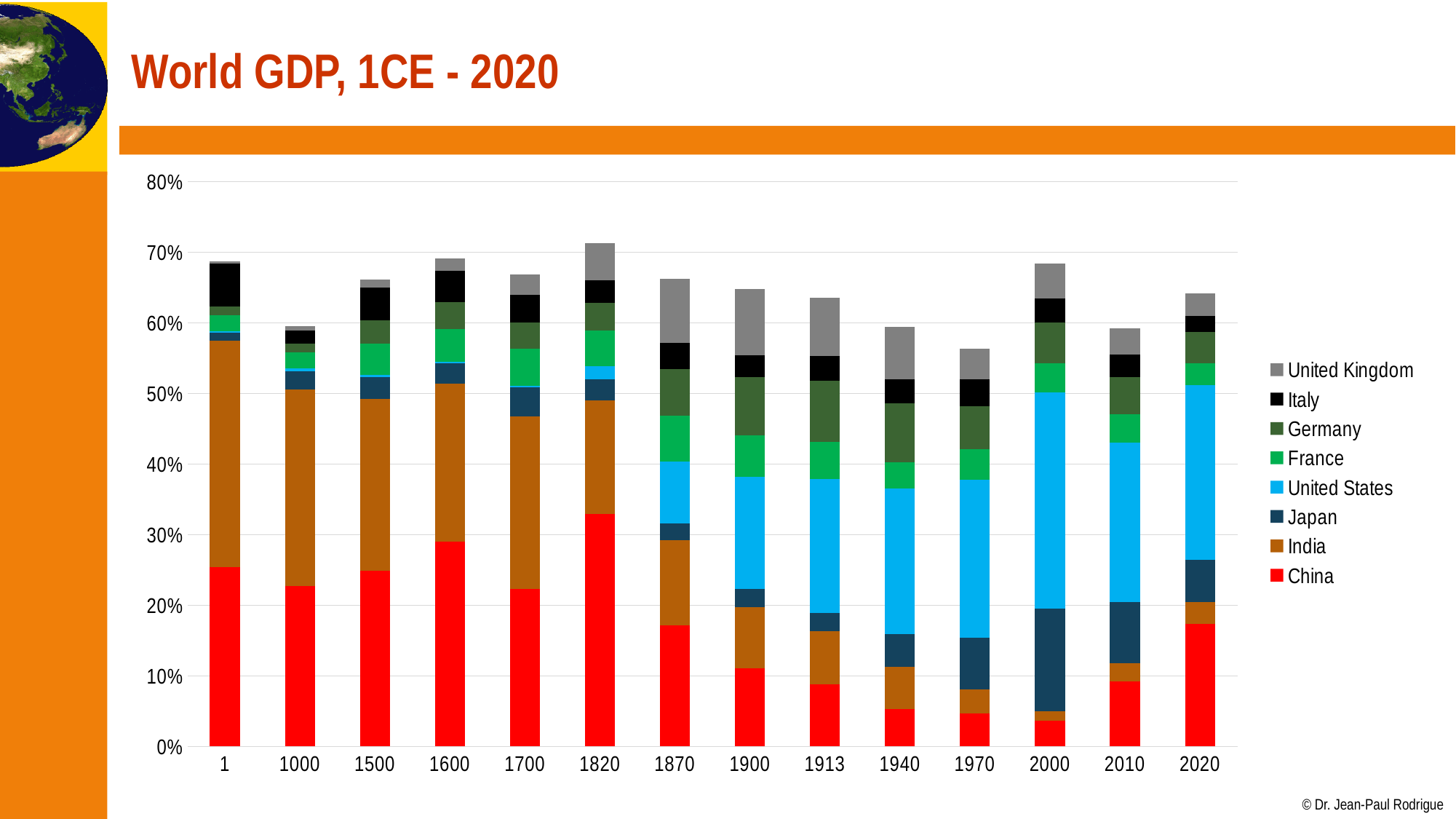
How many years (categories) are shown along the x axis? 14 Is the China segment for 2000 greater or less than 5%? less Which year has the tallest stacked bar overall? 1820 Is the total stacked bar for 1970 greater or less than 60%? less Is the China segment for 1820 greater or less than 30%? greater How many series does the legend list? 8 Which year has the shortest stacked bar overall? 1970 What is the title of the chart on the slide? World GDP, 1CE - 2020 Which is larger, the China segment in year 1 or the China segment in 2020? Year 1 Which is larger, the United States segment in 1870 or in 2000? 2000 What kind of chart is shown on the slide? Stacked bar chart